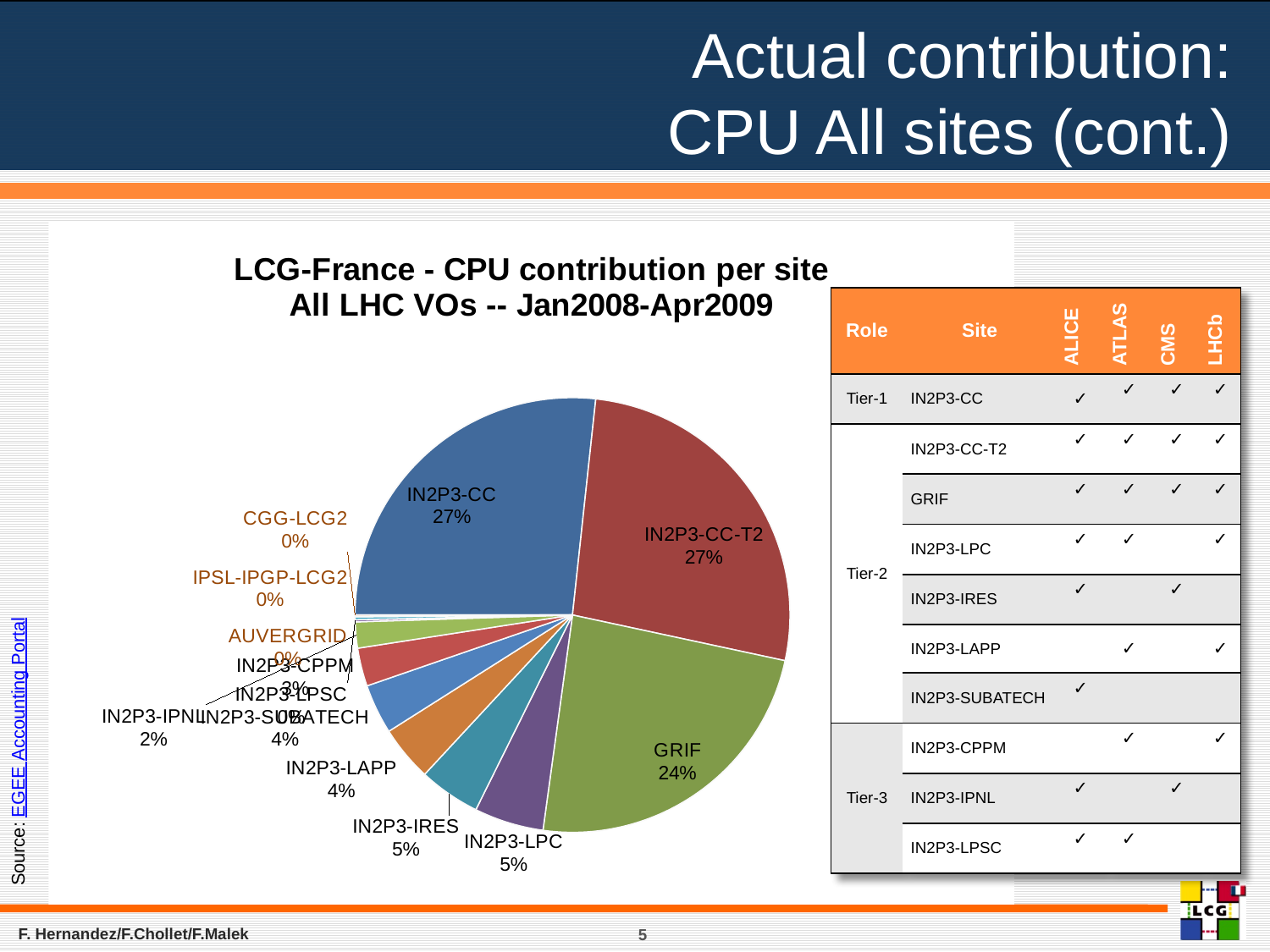
What share of the pie does GRIF account for? 24% What is the share shown for IN2P3-CC-T2? 27% What is the CPU contribution share of IN2P3-CC in the pie chart? 27% What percentage is shown for IN2P3-IPNL? 2% What type of chart is shown on the slide? Pie chart What percentage is shown for IN2P3-LAPP? 4% Which has a larger share, GRIF or IN2P3-CC? IN2P3-CC By how many percentage points does IN2P3-CC's share exceed GRIF's share? 3 percentage points What percentage is shown for IN2P3-IRES? 5% What percentage is shown for AUVERGRID? 0% What is the title of the pie chart? LCG-France - CPU contribution per site All LHC VOs -- Jan2008-Apr2009 What is the combined share of IN2P3-CC, IN2P3-CC-T2 and GRIF? 78%